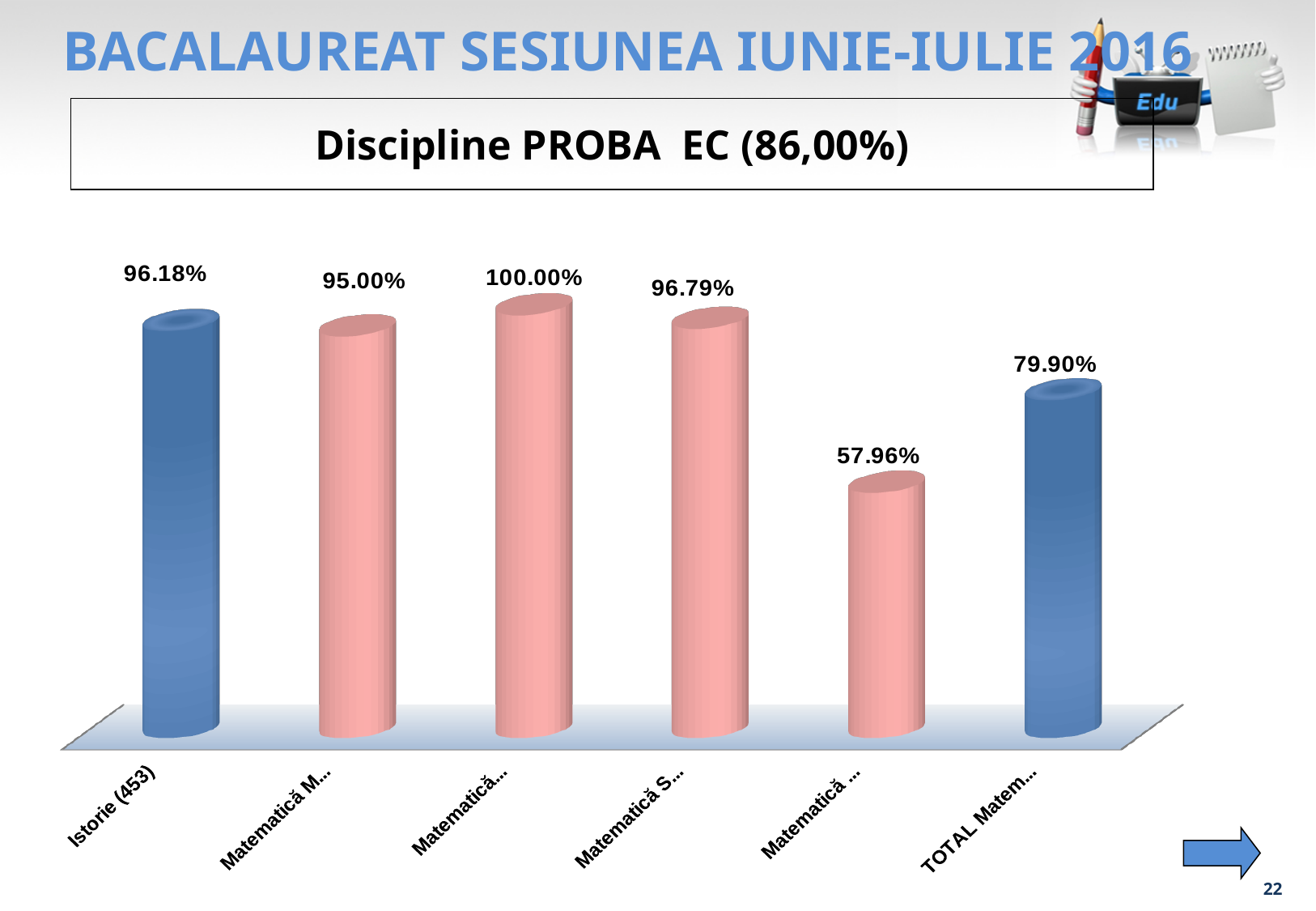
What is the value shown for the third bar from the left? 100.00% Which bar has the lowest value? The fifth bar from the left (57.96%) What is the difference between the highest and lowest values in the chart? 42.04% Which bar has the highest value? The third bar from the left (100.00%) What is the difference between the value for Istorie (453) and the value for the rightmost bar (TOTAL Matem...)? 16.28% Which is larger: the value for Istorie (453) or the value for the fourth bar from the left? The fourth bar from the left (96.79%) What is the value shown for the rightmost bar, labelled TOTAL Matem...? 79.90% How many bars are shown in the chart? 6 What kind of chart is shown on the slide? Bar chart What is the title of the chart? Discipline PROBA EC (86,00%) What is the value shown for the fifth bar from the left? 57.96% What is the value for Istorie (453)? 96.18%